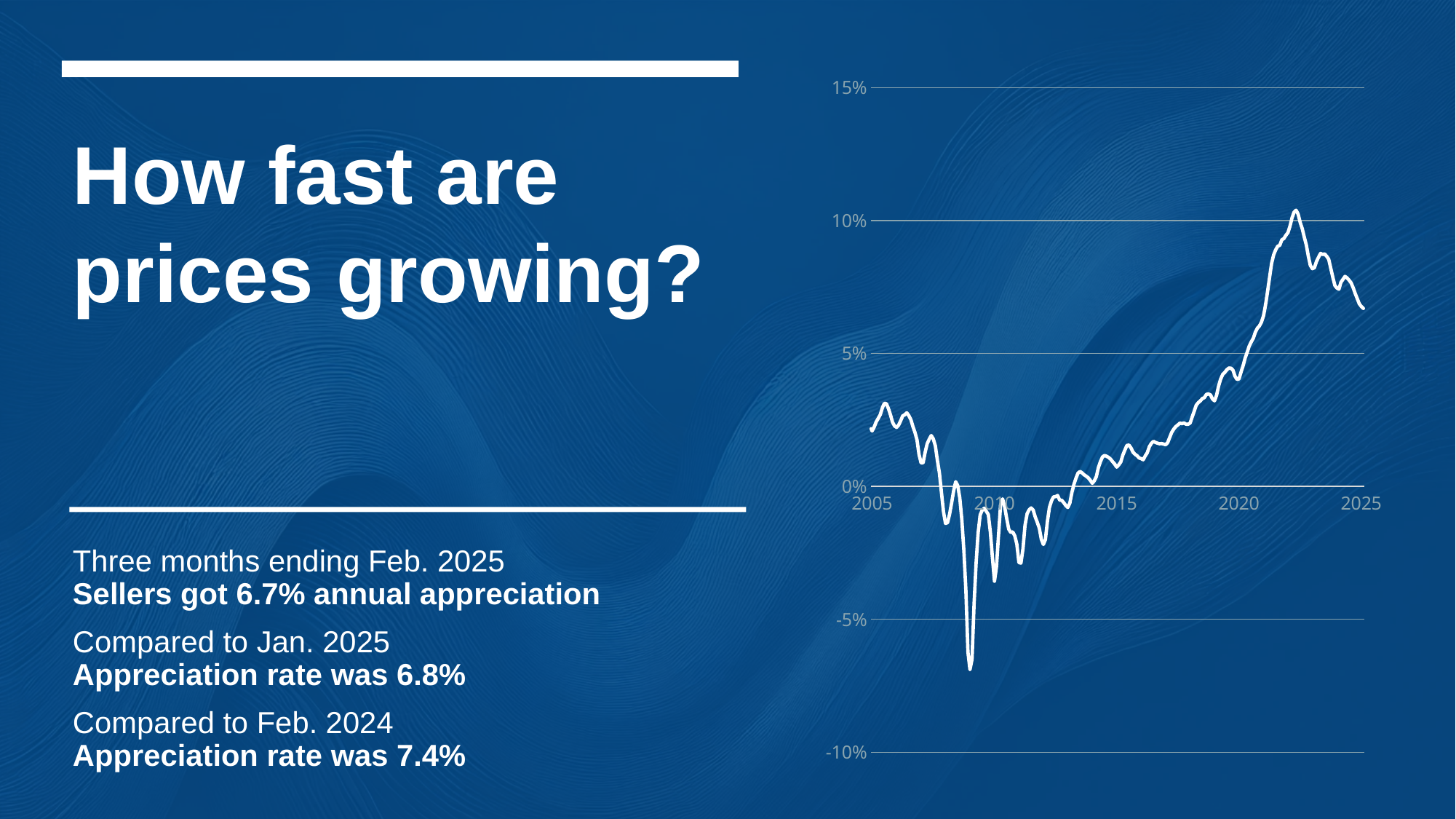
Is the value of the line at 2005 greater or less than 0%? greater Between which two labelled years does the line reach its lowest point? 2005 and 2010 Is the lowest point of the line greater or less than -5%? less How many year labels are shown on the x axis? 5 What is the highest value labelled on the y axis? 15% What kind of chart is shown on the right side of the slide? line chart Is the value of the line at the 2025 end greater or less than 10%? less Between which two labelled years does the line reach its highest point? 2020 and 2025 Does the line generally rise or fall between 2010 and 2020? rise